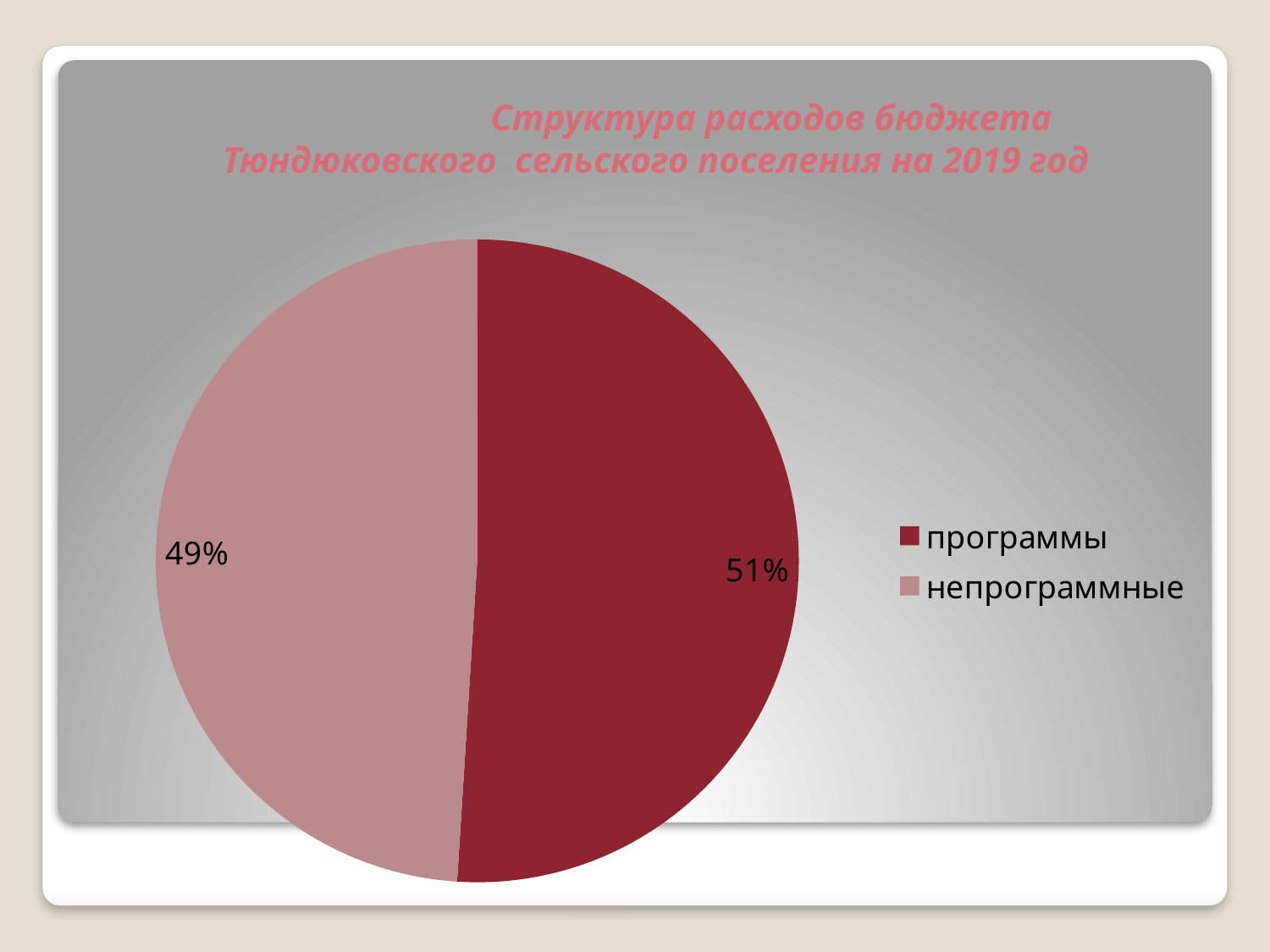
How many slices does the pie chart have? 2 What share of the pie does the "непрограммные" slice represent? 49% Which category is shown in the darker red colour? программы What is the title of the chart? Структура расходов бюджета Тюндюковского сельского поселения на 2019 год What kind of chart is shown on the slide? pie chart What share of the pie does the "программы" slice represent? 51% Which category has the largest slice of the pie? программы By how many percentage points does the "программы" share exceed the "непрограммные" share? 2 How many entries does the legend list? 2 Which is larger, the share for "программы" or the share for "непрограммные"? программы Which category has the smallest slice of the pie? непрограммные